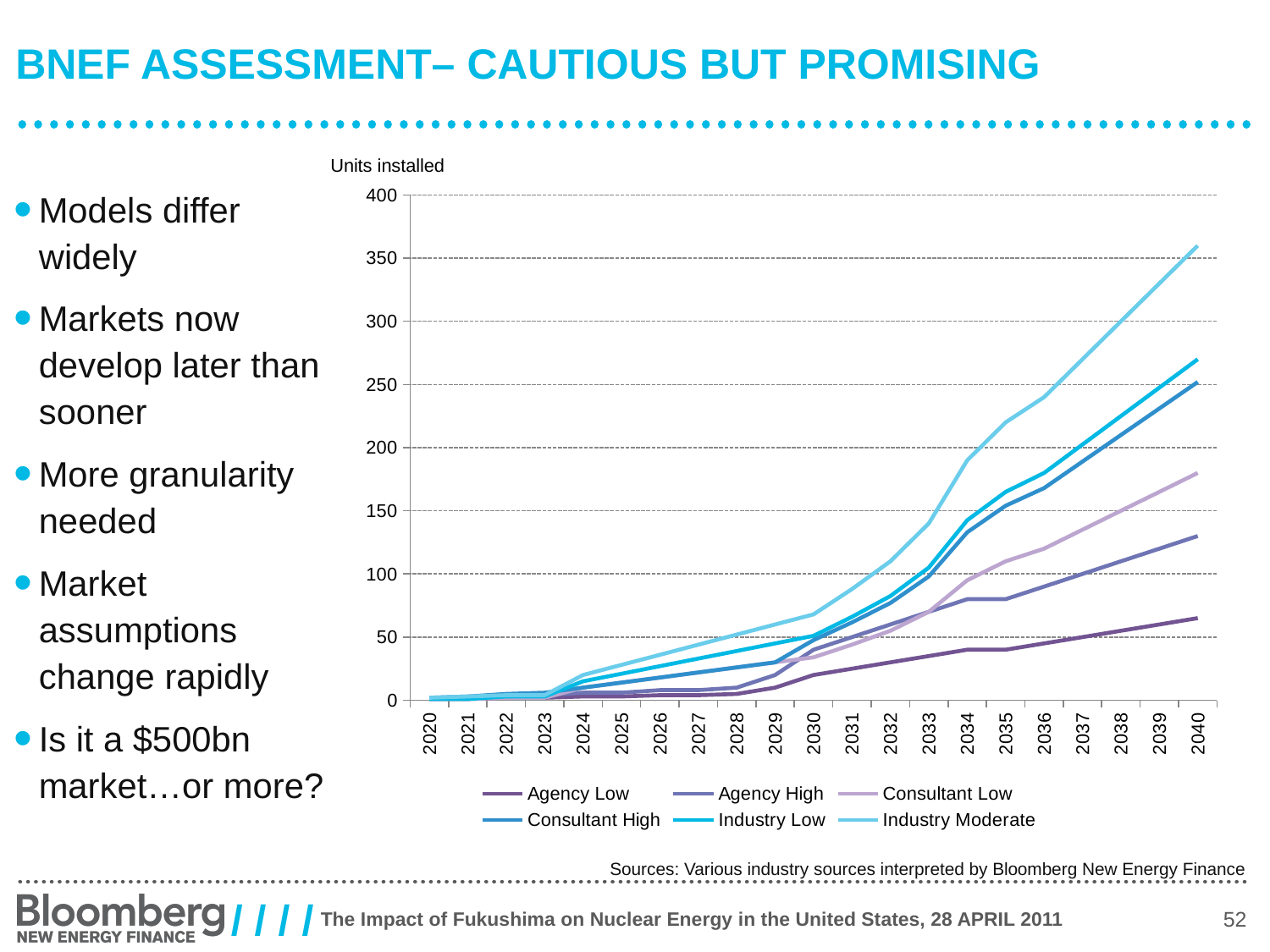
What kind of chart is shown on the slide? Line chart What label is shown above the y axis of the chart? Units installed Do the values for Industry Moderate rise or fall from 2020 to 2040? Rise Which series has the highest value in 2040? Industry Moderate Is the value for Industry Moderate in 2040 greater or less than 300? greater How many series does the legend list? 6 How many years are shown along the x axis? 21 Is the value for Consultant Low in 2040 greater or less than 150? greater Which series has the lowest value in 2040? Agency Low Is the value for Agency High in 2040 greater or less than 100? greater In 2040, which is larger: Industry Low or Consultant Low? Industry Low